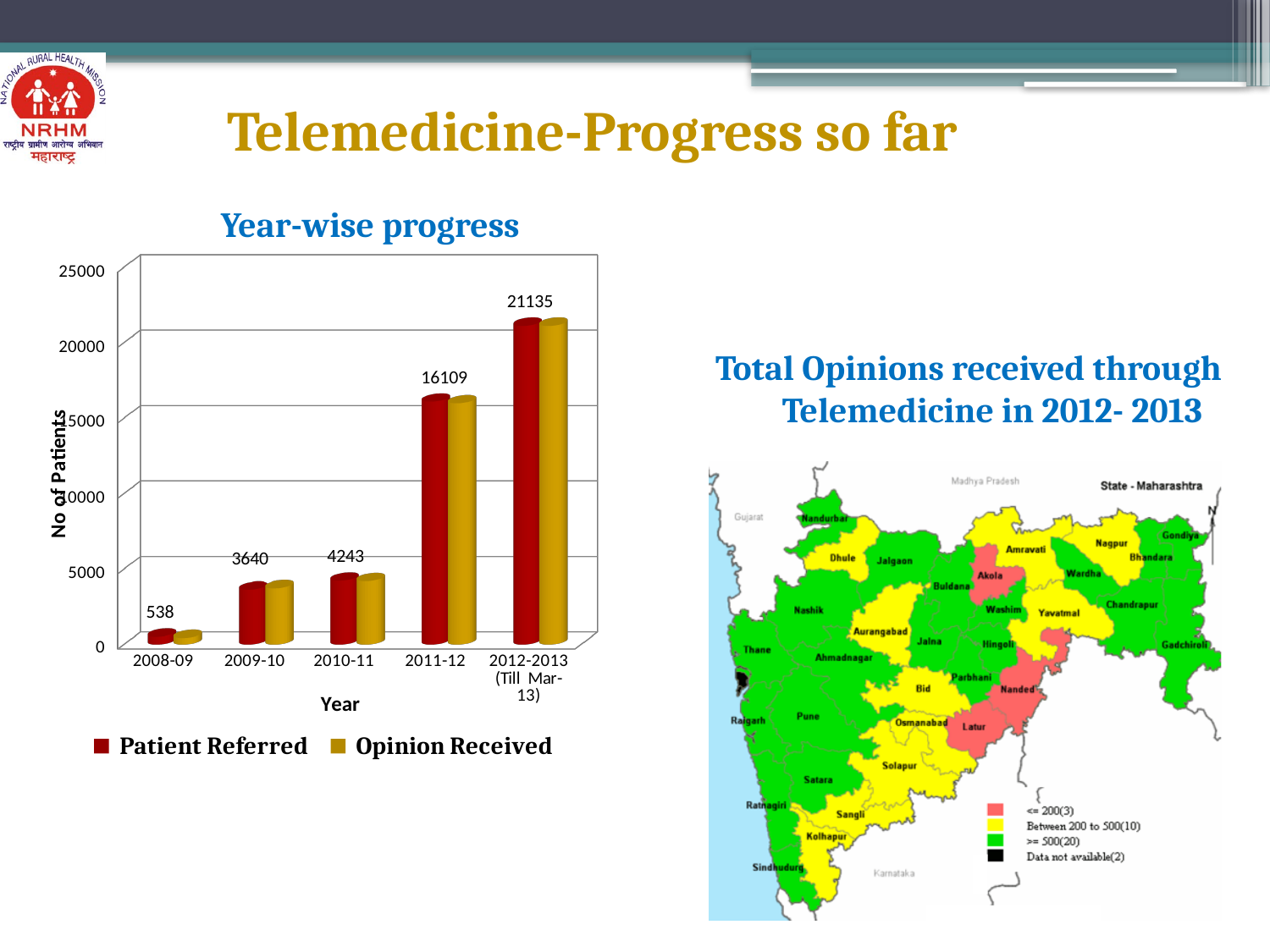
What kind of chart is the 'Year-wise progress' chart? Bar chart How many series does the legend of the 'Year-wise progress' chart list? 2 In the 'Year-wise progress' chart, what is the difference between the labelled values for 2010-11 and 2009-10? 603 How many years are shown on the x axis of the 'Year-wise progress' chart? 5 In the 'Year-wise progress' chart, what is the difference between the labelled values for 2012-2013 and 2011-12? 5026 In the 'Year-wise progress' chart, is the Opinion Received value for 2011-12 greater or less than 15000? greater In the 'Year-wise progress' chart, what value is labelled for 2012-2013 (Till Mar-13)? 21135 In the 'Year-wise progress' chart, which year has the highest number of patients? 2012-2013 (Till Mar-13) In the 'Year-wise progress' chart, what value is labelled for 2011-12? 16109 In the 'Year-wise progress' chart, what value is labelled for 2008-09? 538 In the 'Year-wise progress' chart, which year has the lowest number of patients? 2008-09 In the 'Year-wise progress' chart, do the values rise or fall from 2008-09 to 2012-2013? Rise